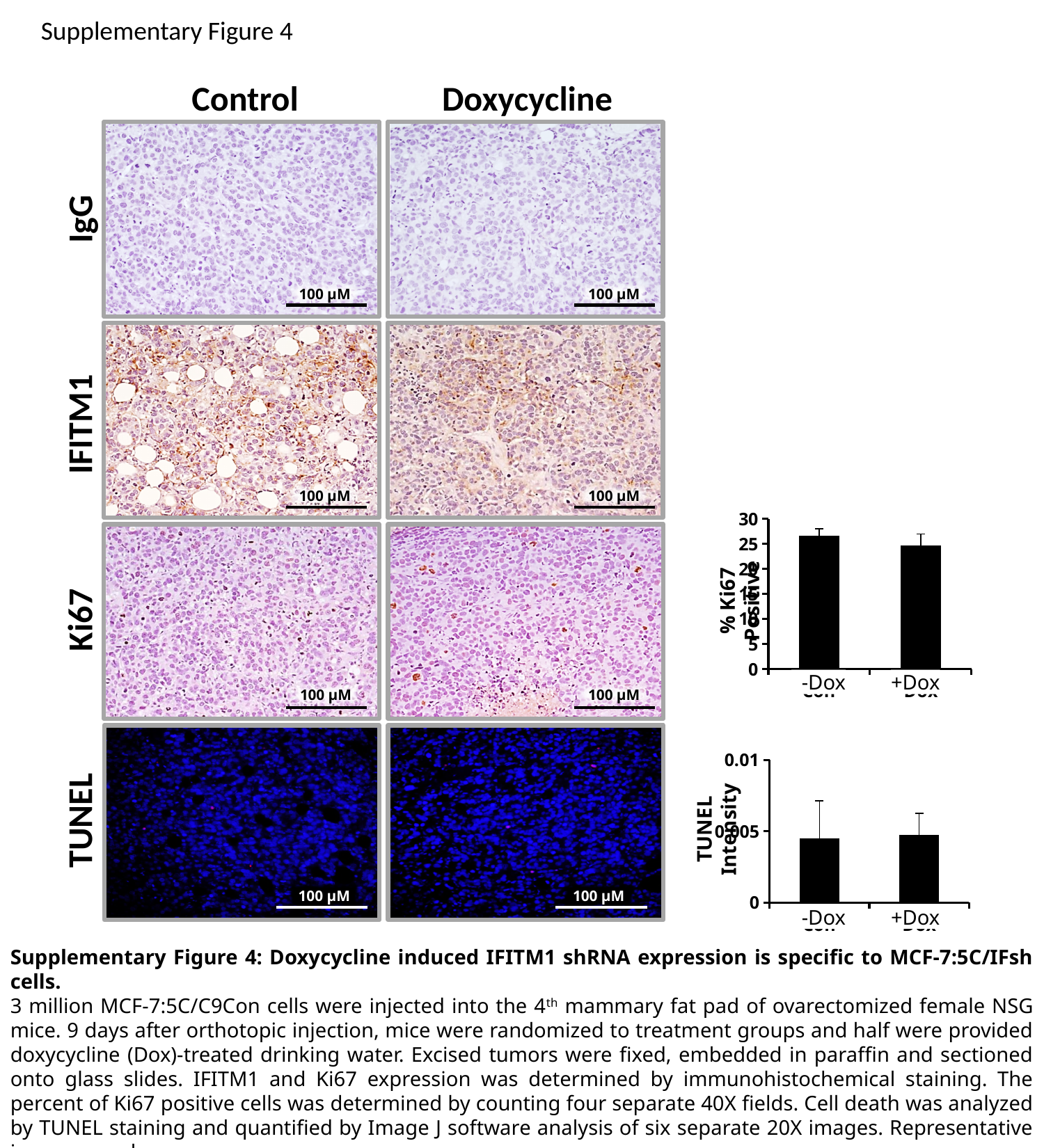
In the "% Ki67 Positive" chart, is the value for -Dox greater or less than 20? greater What colour are the bars in the "% Ki67 Positive" chart? black In the "% Ki67 Positive" chart, is the value for +Dox greater or less than 20? greater In the "% Ki67 Positive" chart, is the value for +Dox greater or less than 30? less What kind of chart is the "TUNEL Intensity" chart at the bottom right of the slide? bar chart In the "% Ki67 Positive" chart, which bar is taller, -Dox or +Dox? -Dox How many bars are plotted in the "TUNEL Intensity" chart? 2 What kind of chart is the "% Ki67 Positive" chart on the right of the slide? bar chart How many categories are shown on the x axis of the "% Ki67 Positive" chart? 2 What is the highest tick value shown on the y axis of the "TUNEL Intensity" chart? 0.01